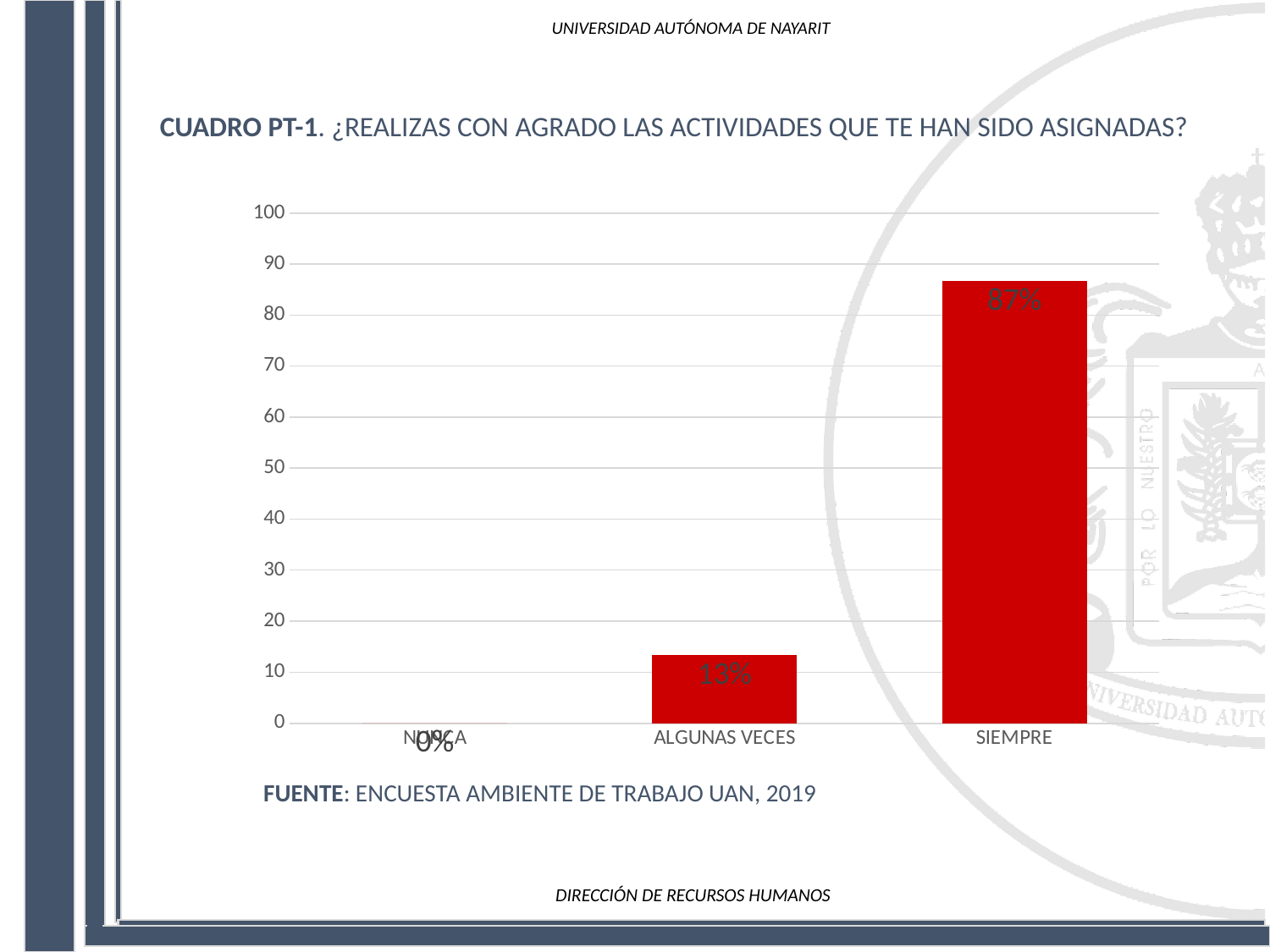
What source is cited below the chart? ENCUESTA AMBIENTE DE TRABAJO UAN, 2019 Is the value for SIEMPRE greater or less than 80? greater What is the difference between the values for SIEMPRE and ALGUNAS VECES? 74% How many categories are shown on the x axis? 3 What is the value for SIEMPRE? 87% What kind of chart is shown on the slide? bar chart Is the value for ALGUNAS VECES greater or less than 20? less Which category has the highest value? SIEMPRE What is the value for NUNCA? 0% Which is larger, the value for ALGUNAS VECES or the value for SIEMPRE? SIEMPRE Which category has the lowest value? NUNCA What is the value for ALGUNAS VECES? 13%